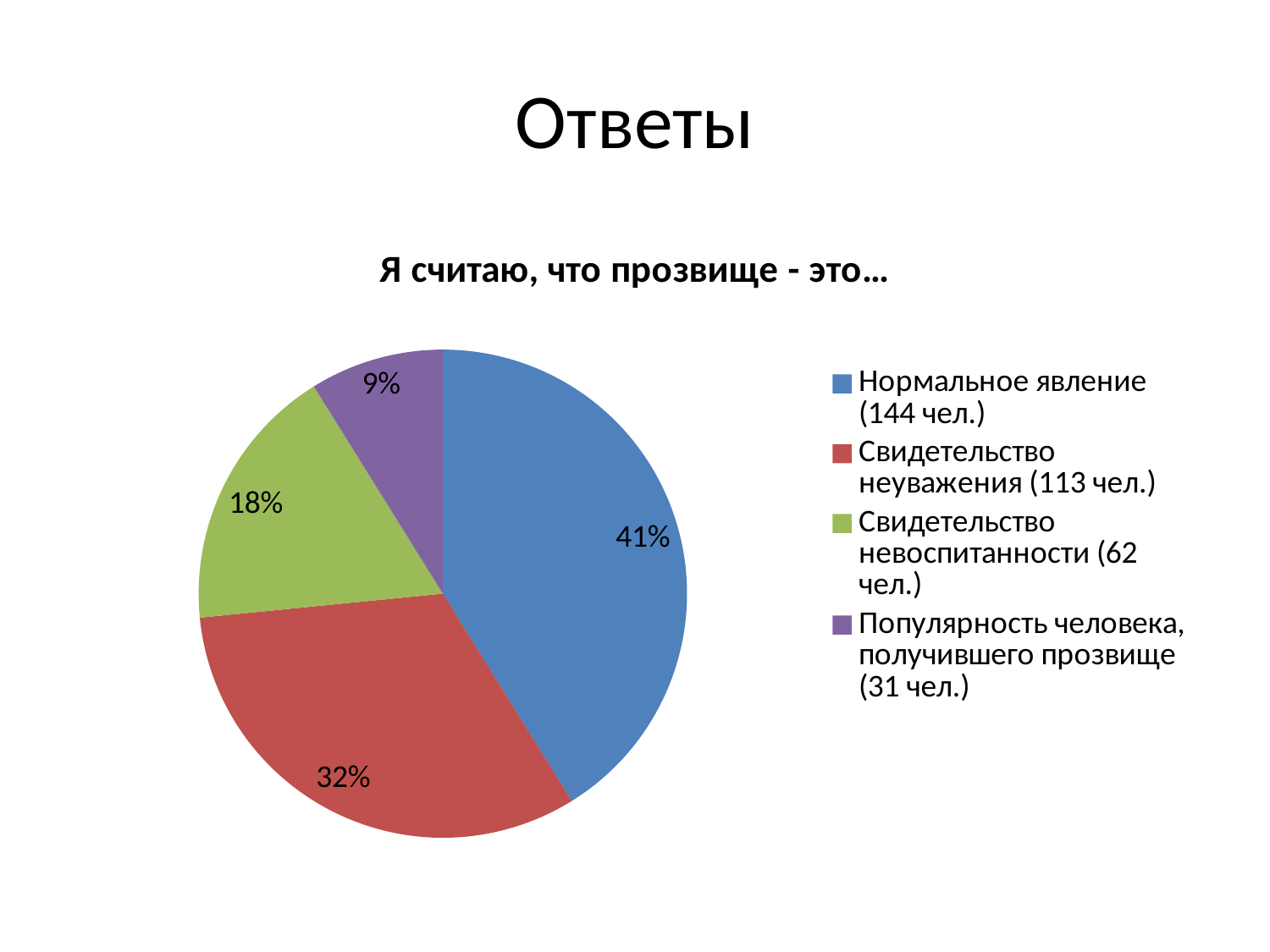
What colour is the slice for "Свидетельство неуважения (113 чел.)"? red What is the title of the chart? Я считаю, что прозвище - это… What share of the pie is labelled for "Свидетельство невоспитанности (62 чел.)"? 18% What kind of chart is shown on the slide? pie chart How many slices does the pie chart have? 4 What share of the pie is labelled for "Свидетельство неуважения (113 чел.)"? 32% Which category has the smallest slice of the pie? Популярность человека, получившего прозвище (31 чел.) Which category has the largest slice of the pie? Нормальное явление (144 чел.) What share of the pie is labelled for "Нормальное явление (144 чел.)"? 41% What is the difference in percentage points between the "Нормальное явление" slice and the "Свидетельство неуважения" slice? 9 Which slice is larger: "Свидетельство невоспитанности" or "Популярность человека, получившего прозвище"? Свидетельство невоспитанности